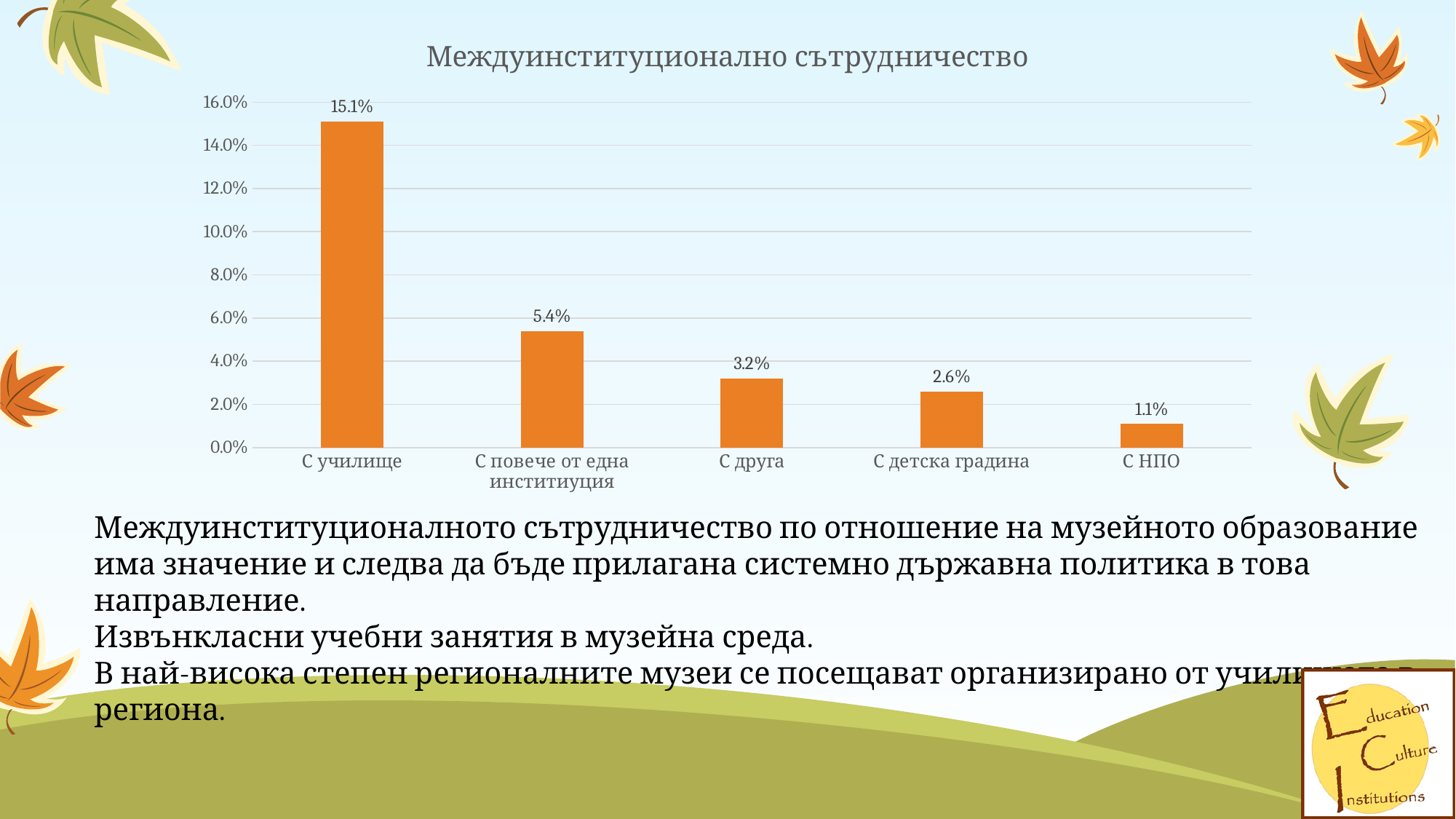
Is the value for С друга greater or less than 4.0%? less What is the difference between the values for С училище and С повече от една институция? 9.7% Which category has the lowest value? С НПО What is the value for С училище? 15.1% What kind of chart is shown on the slide? bar chart What is the value for С повече от една институция? 5.4% What is the title of the chart? Междуинституционално сътрудничество What is the value for С НПО? 1.1% What is the value for С детска градина? 2.6% Which is larger, the value for С друга or the value for С детска градина? С друга Which category has the highest value? С училище How many categories are shown in the chart? 5